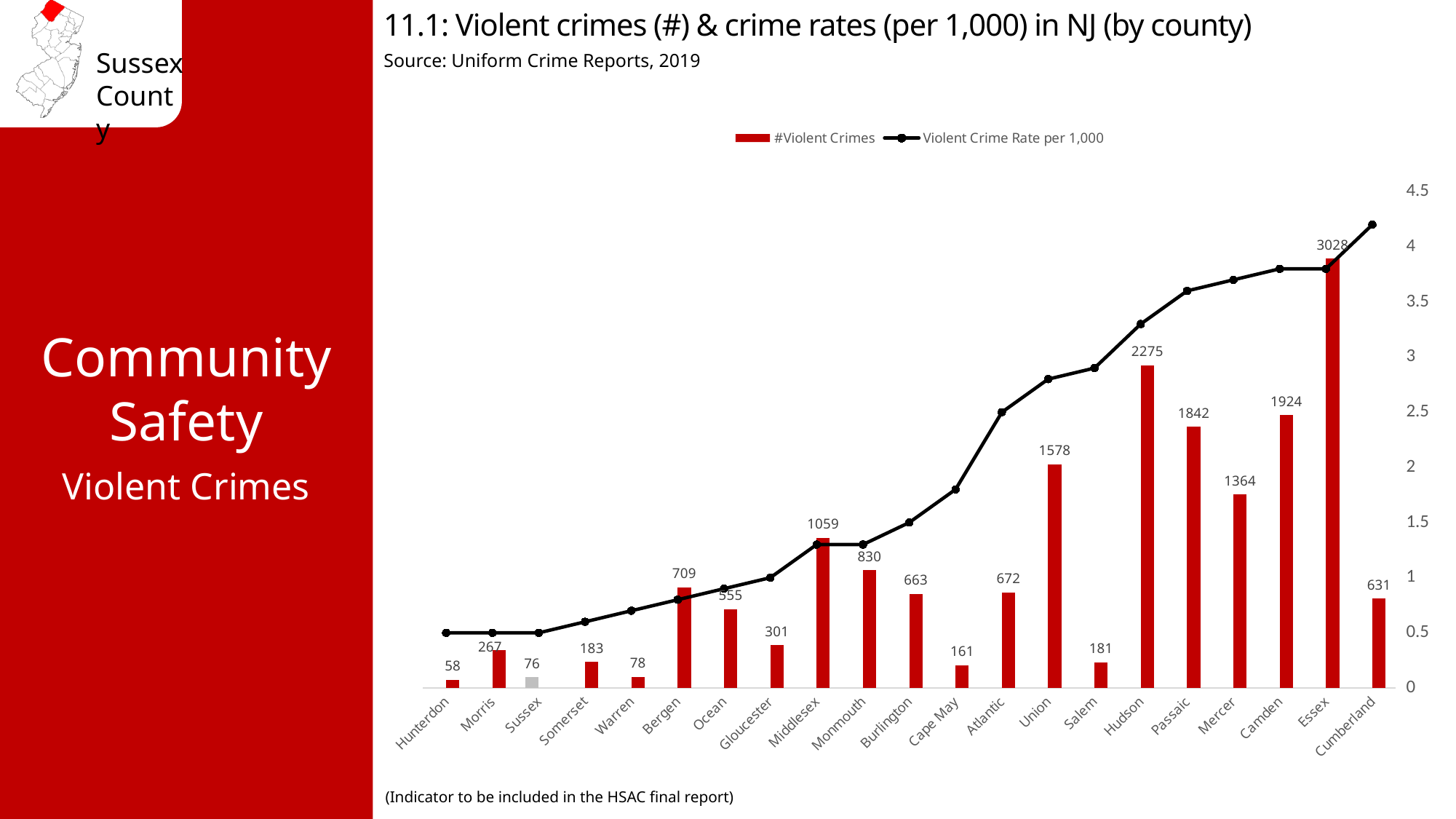
How many series does the legend list? 2 What kind of chart is this? Combined bar and line chart Which county has the highest number of violent crimes? Essex What is the number of violent crimes for Essex? 3028 Does the violent crime rate per 1,000 generally rise or fall from Hunterdon to Cumberland along the x axis? rise What is the difference in the number of violent crimes between Hudson and Passaic? 433 Is the violent crime rate per 1,000 for Hunterdon greater or less than 1? less Which county has the lowest number of violent crimes? Hunterdon How many counties are shown on the x axis? 21 Is the violent crime rate per 1,000 for Cumberland greater or less than 4? greater Which county has more violent crimes, Camden or Passaic? Camden How many violent crimes are shown for Sussex County? 76